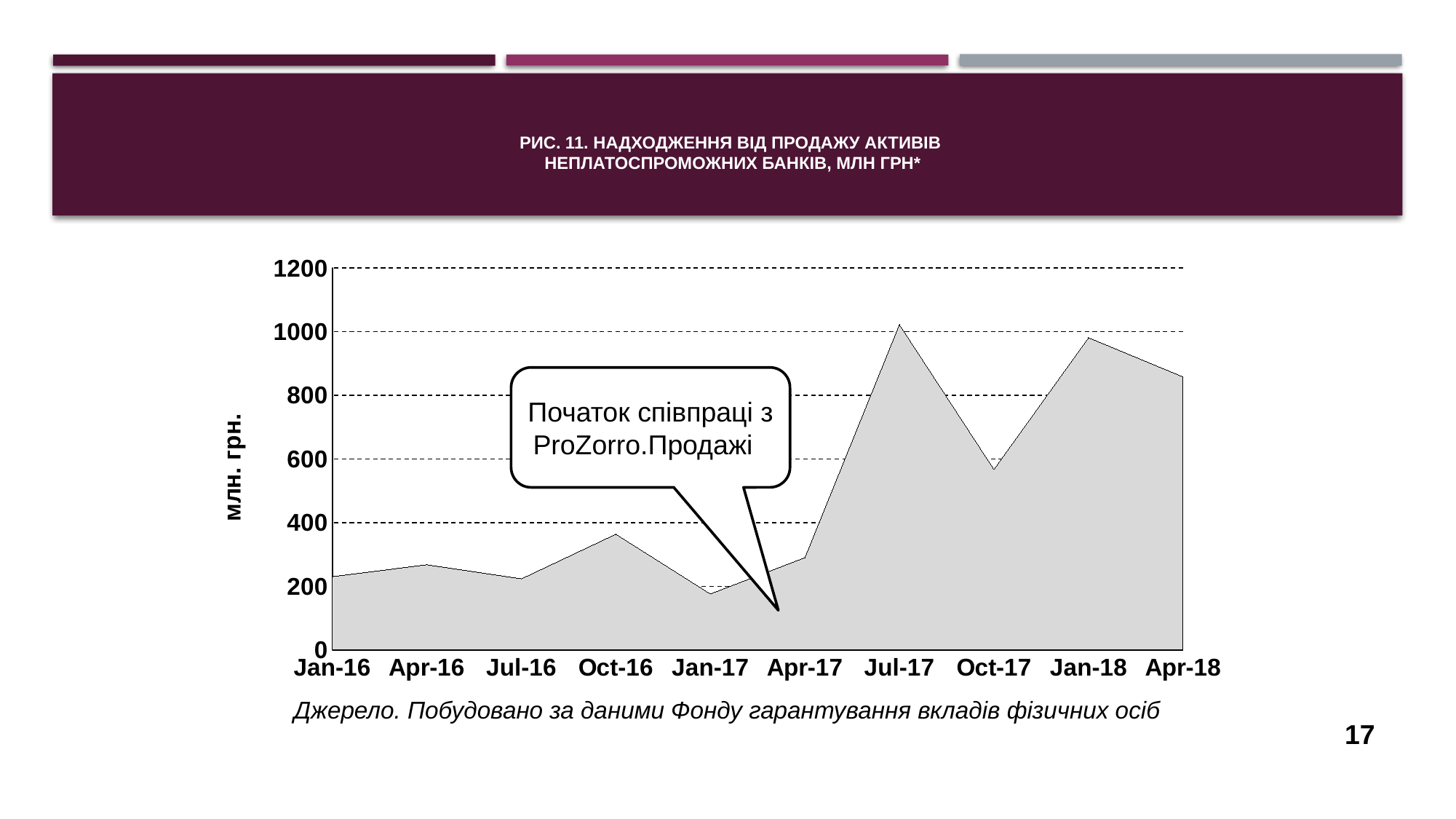
Is the value for Oct-16 greater or less than 400? less Is the value for Jan-16 greater or less than 400? less How many dates are labelled on the x axis of the chart? 10 Is the value for Jan-18 greater or less than 800? greater What is the label on the vertical axis of the chart? млн. грн. Which date has the highest value on the chart? Jul-17 Which is larger, the value for Oct-16 or the value for Jan-17? Oct-16 Which date has the lowest value on the chart? Jan-17 What kind of chart is shown on the slide? Area chart Which is larger, the value for Jul-17 or the value for Oct-17? Jul-17 Overall, do the values rise or fall from Jan-16 to Apr-18? Rise